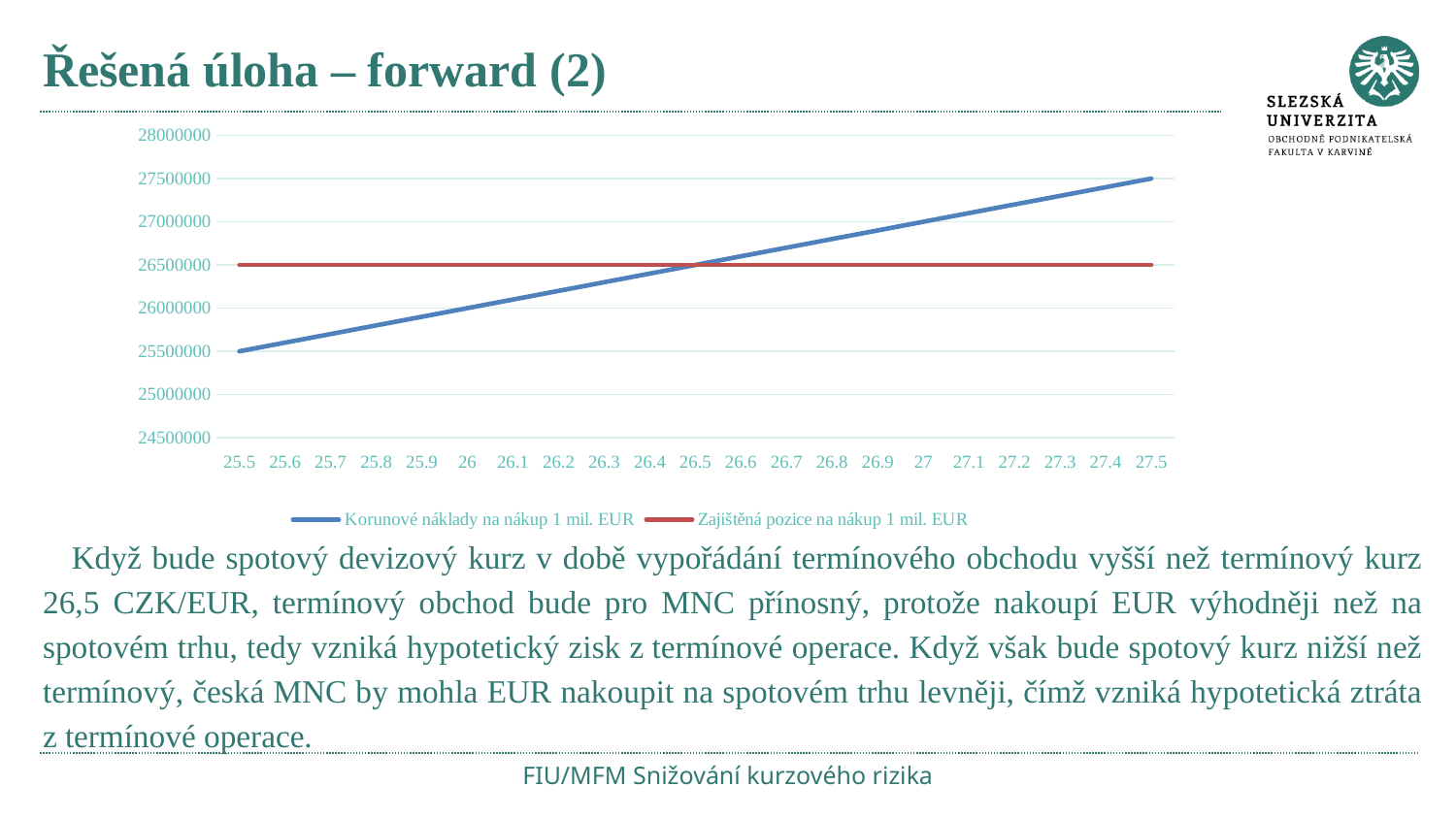
Is the value of 'Korunové náklady na nákup 1 mil. EUR' at 26.2 greater or less than 26500000? less What is the value of 'Korunové náklady na nákup 1 mil. EUR' at 25.5? 25500000 At 25.5, which series has the larger value: 'Korunové náklady na nákup 1 mil. EUR' or 'Zajištěná pozice na nákup 1 mil. EUR'? Zajištěná pozice na nákup 1 mil. EUR How many series does the chart legend list? 2 At which x-axis value do the two lines in the chart cross? 26.5 What constant value does the series 'Zajištěná pozice na nákup 1 mil. EUR' take across the chart? 26500000 What is the difference between 'Korunové náklady na nákup 1 mil. EUR' at 27.5 and 'Zajištěná pozice na nákup 1 mil. EUR'? 1000000 Does the series 'Korunové náklady na nákup 1 mil. EUR' rise or fall as the x-axis value increases? rise What kind of chart is shown on the slide? line chart At 27, which series has the larger value: 'Korunové náklady na nákup 1 mil. EUR' or 'Zajištěná pozice na nákup 1 mil. EUR'? Korunové náklady na nákup 1 mil. EUR How many points are labelled along the x axis of the chart? 21 What is the value of 'Korunové náklady na nákup 1 mil. EUR' at 27.5? 27500000